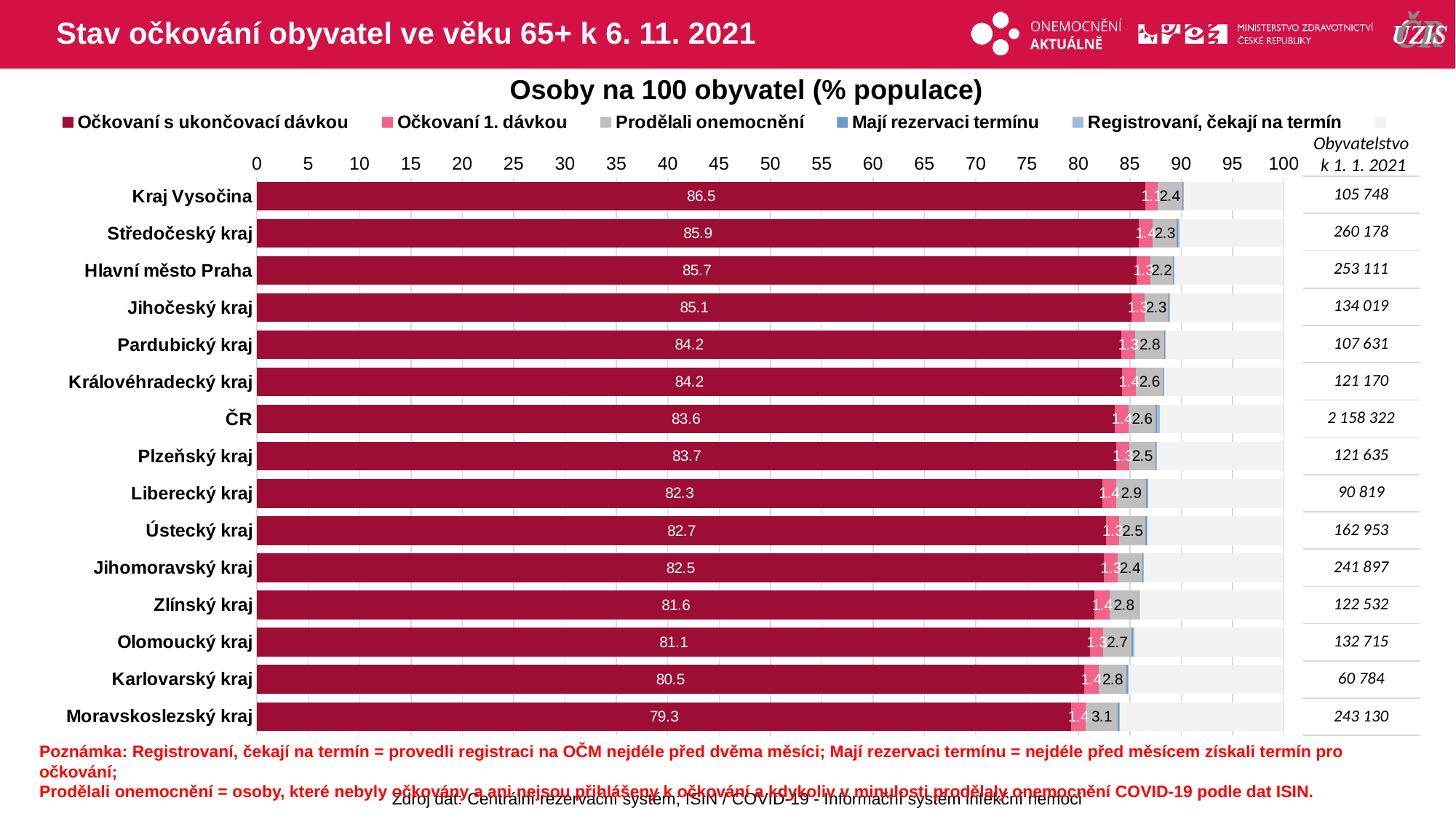
What is the value of 'Prodělali onemocnění' for Moravskoslezský kraj? 3.1 What is the title of the chart? Osoby na 100 obyvatel (% populace) What is the value of 'Očkovaní s ukončovací dávkou' for Kraj Vysočina? 86.5 What is the difference in 'Očkovaní s ukončovací dávkou' between Kraj Vysočina and Moravskoslezský kraj? 7.2 What is the value of 'Očkovaní s ukončovací dávkou' for ČR? 83.6 What is the value of 'Očkovaní 1. dávkou' for Kraj Vysočina? 1.1 What type of chart is shown on the slide? stacked bar chart Is the value of 'Očkovaní s ukončovací dávkou' for Zlínský kraj greater or less than 75? greater Which has a larger value of 'Očkovaní s ukončovací dávkou': Hlavní město Praha or Olomoucký kraj? Hlavní město Praha Which region has the highest value of 'Očkovaní s ukončovací dávkou'? Kraj Vysočina How many regions (categories) are plotted in the chart? 15 Which region has the lowest value of 'Očkovaní s ukončovací dávkou'? Moravskoslezský kraj